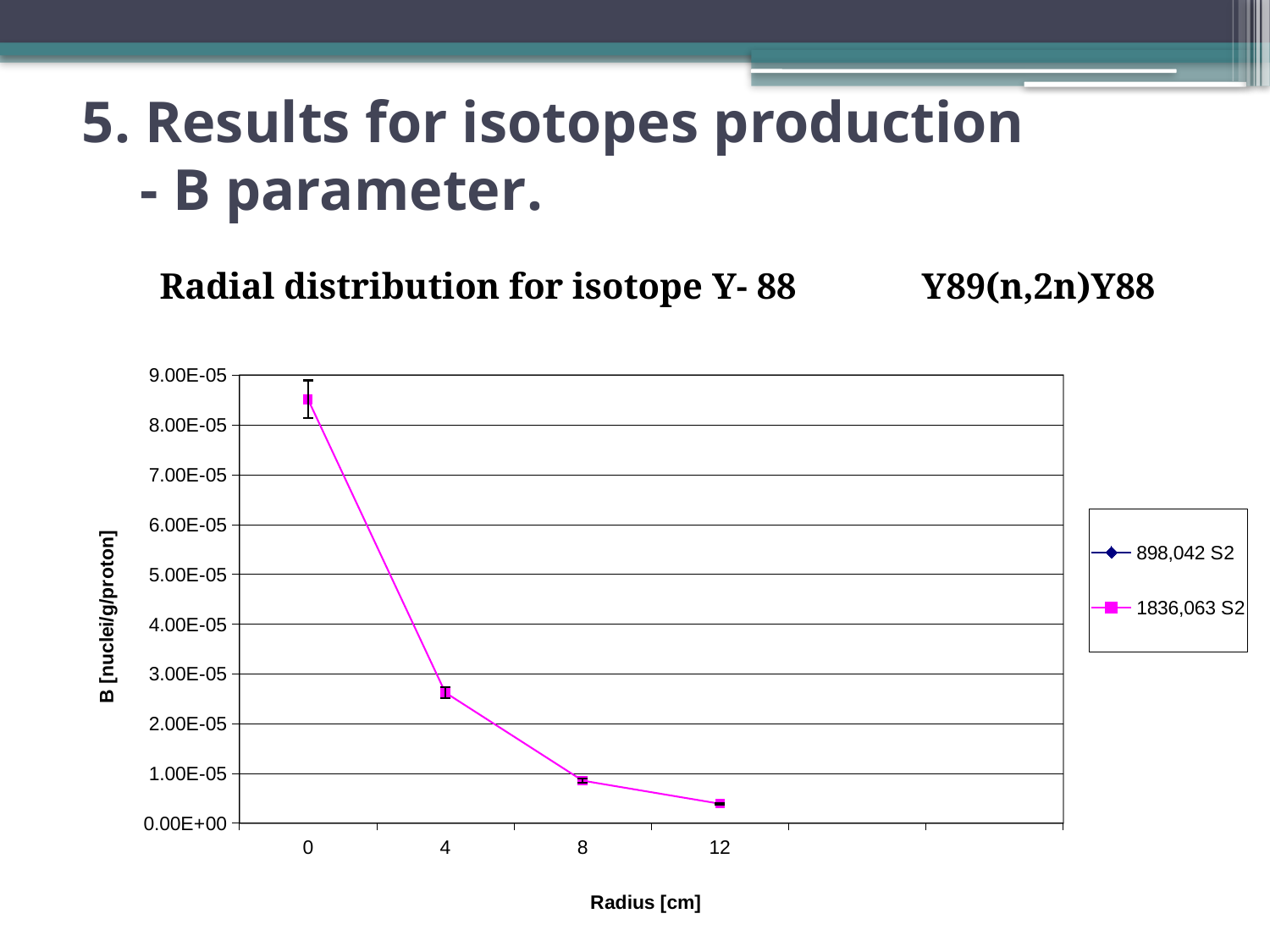
What is the label of the x axis? Radius [cm] Do the values of the 1836,063 S2 series rise or fall as the radius increases? fall What is the title of the chart? Radial distribution for isotope Y- 88 At which radius is the value of the 1836,063 S2 series lowest? 12 Which is larger for the 1836,063 S2 series: the value at radius 4 or the value at radius 8? radius 4 Is the value for the 1836,063 S2 series at radius 8 greater or less than 1.00E-05? less At which radius is the value of the 1836,063 S2 series highest? 0 Is the value for the 1836,063 S2 series at radius 4 greater or less than 3.00E-05? less How many series does the legend list? 2 What kind of chart is shown on the slide? line chart Is the value for the 1836,063 S2 series at radius 0 greater or less than 8.00E-05? greater How many data points are plotted for the 1836,063 S2 series? 4